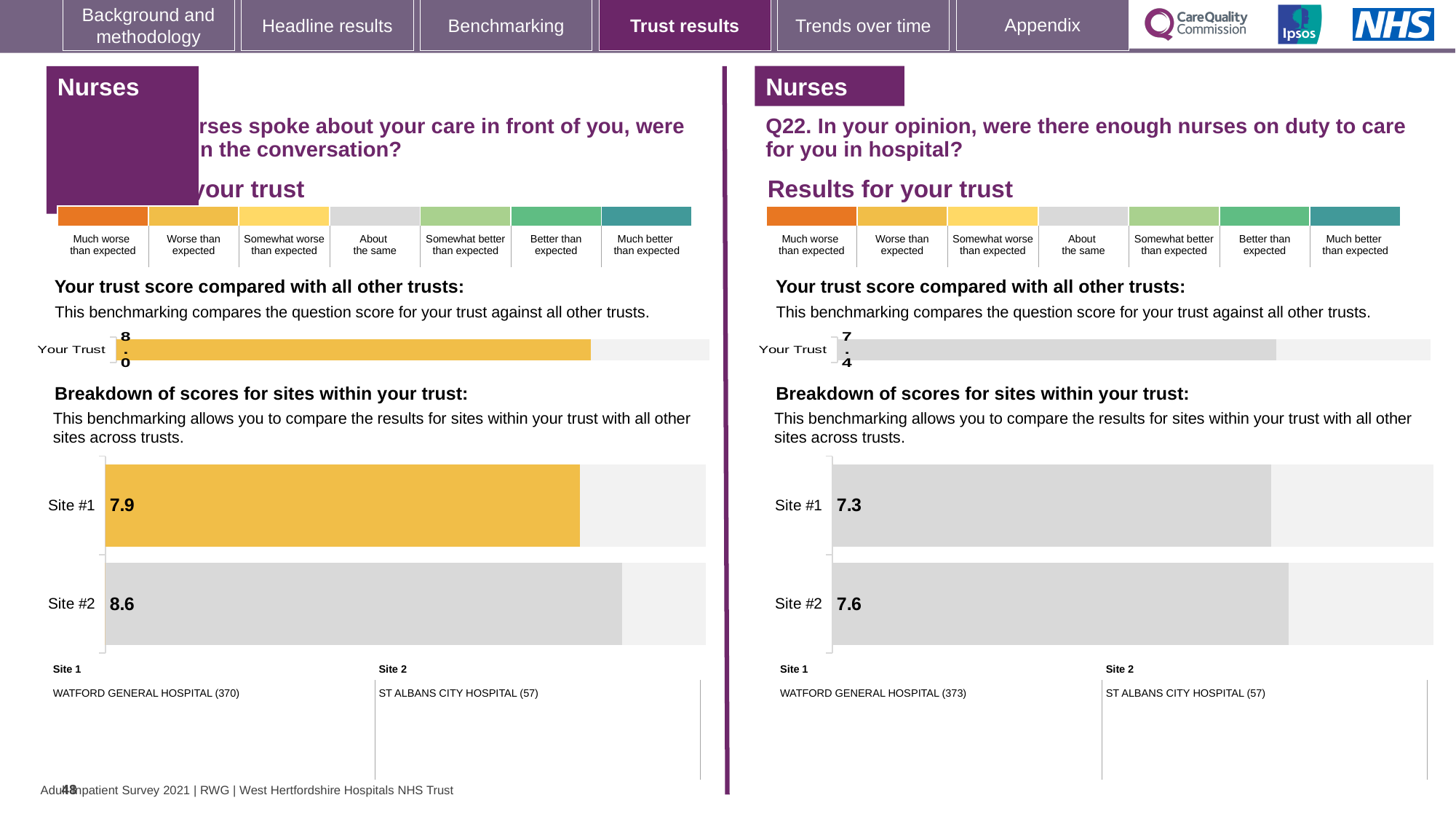
How many sites are shown in the site breakdown chart on the right half of the slide (Q22)? 2 In the site breakdown chart on the right half of the slide (Q22), what is the difference between the Site #2 and Site #1 scores? 0.3 In the site breakdown chart on the left half of the slide, what is the difference between the Site #2 and Site #1 scores? 0.7 What type of chart is used to show the site breakdown of scores on the left half of the slide? Bar chart In the 'Your Trust' chart on the left half of the slide, what is the trust score shown? 8.0 In the 'Your Trust' chart on the right half of the slide (Q22), what is the trust score shown? 7.4 In the site breakdown chart on the left half of the slide, which site has the higher score? Site #2 In the site breakdown chart on the left half of the slide, what is the score for Site #2? 8.6 In the site breakdown chart on the right half of the slide (Q22), which site has the lower score? Site #1 In the site breakdown chart on the left half of the slide, what is the score for Site #1? 7.9 In the site breakdown chart on the right half of the slide (Q22), what is the score for Site #1? 7.3 In the site breakdown chart on the right half of the slide (Q22), what is the score for Site #2? 7.6